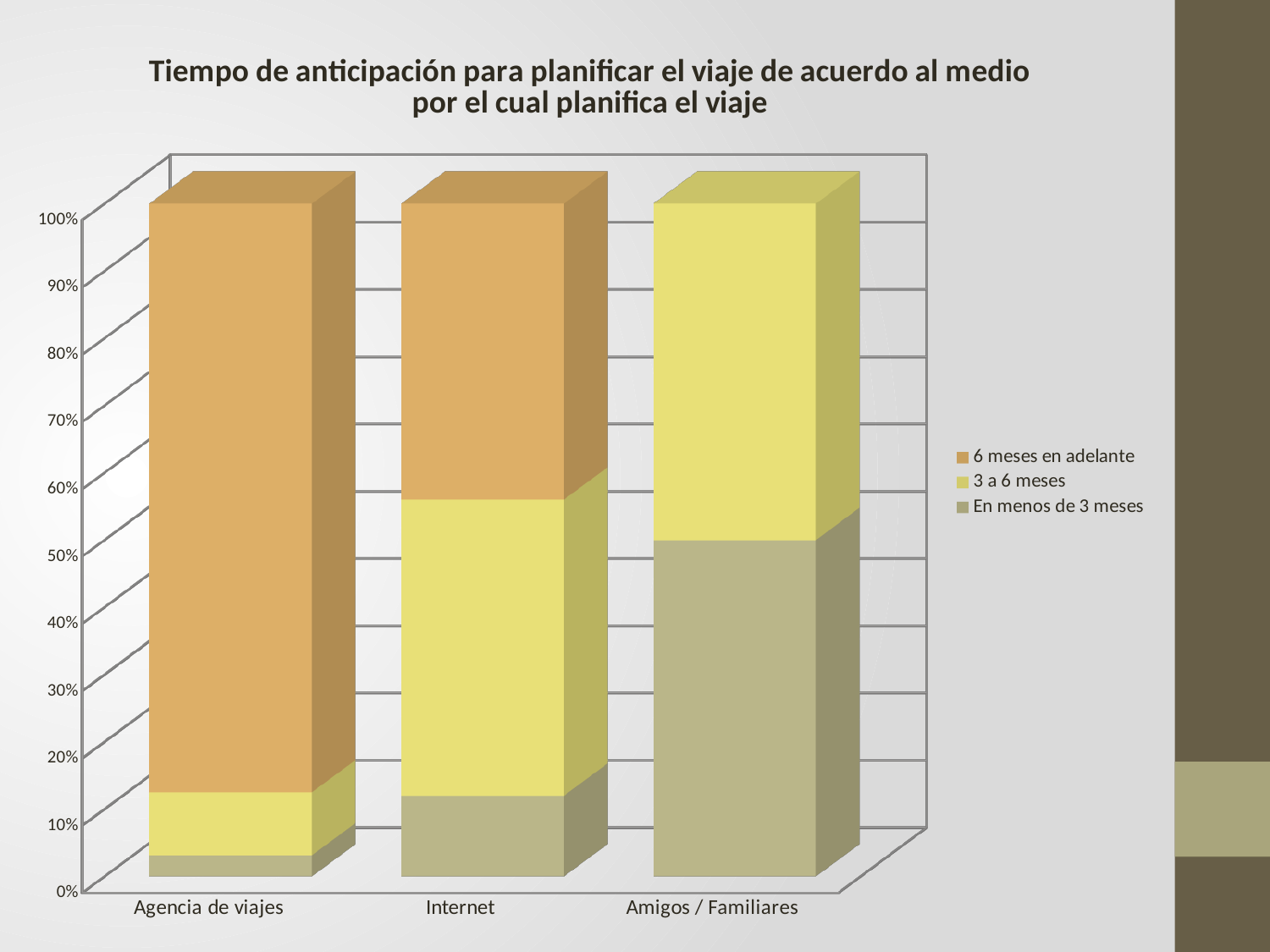
What kind of chart is shown on the slide? Stacked bar chart Which is larger: the '6 meses en adelante' share for Agencia de viajes or for Internet? Agencia de viajes What is the title of the chart? Tiempo de anticipación para planificar el viaje de acuerdo al medio por el cual planifica el viaje Which category has the largest share for 'En menos de 3 meses'? Amigos / Familiares Which category has the largest share for '6 meses en adelante'? Agencia de viajes Is the 'En menos de 3 meses' share for Agencia de viajes greater or less than 10%? less How many categories are shown on the x axis? 3 Which category has the smallest share for '6 meses en adelante'? Amigos / Familiares How many series does the legend list? 3 Does the '6 meses en adelante' share rise or fall from Agencia de viajes to Amigos / Familiares? Fall Is the '6 meses en adelante' share for Agencia de viajes greater or less than 80%? greater Which category has the smallest share for 'En menos de 3 meses'? Agencia de viajes